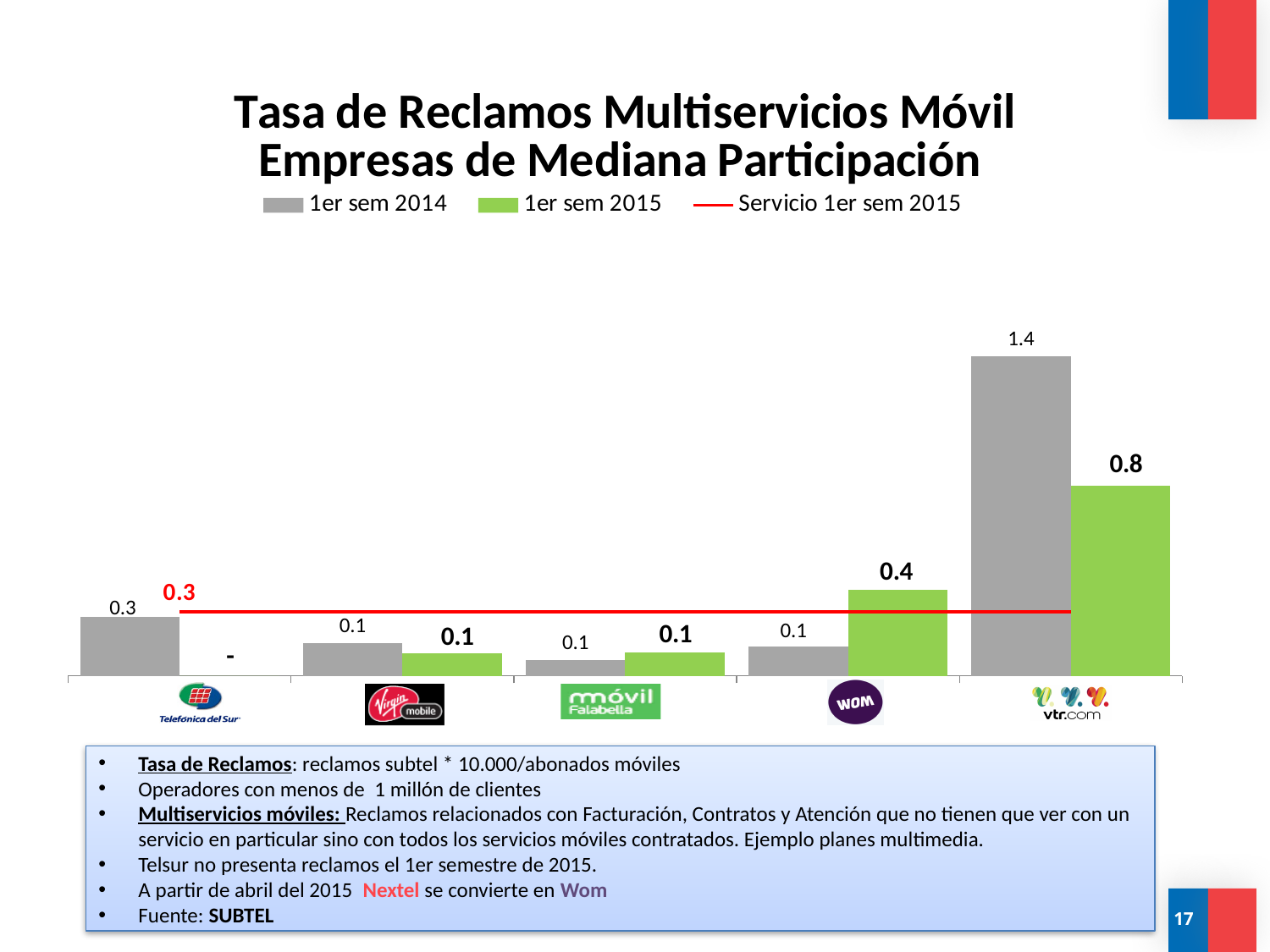
Which company has the highest value in the 1er sem 2015 series? VTR What is the value for Telefónica del Sur in the 1er sem 2014 series? 0.3 What is the value for VTR in the 1er sem 2015 series? 0.8 What kind of chart is shown on the slide? Combination bar and line chart Which is larger for WOM: the 1er sem 2014 value or the 1er sem 2015 value? 1er sem 2015 What is the difference between VTR's 1er sem 2014 value and its 1er sem 2015 value? 0.6 How many companies are shown on the x axis of the chart? 5 How many entries does the chart legend list? 3 What is the value for WOM in the 1er sem 2015 series? 0.4 What is the value for VTR in the 1er sem 2014 series? 1.4 What value does the red 'Servicio 1er sem 2015' line show? 0.3 Which company has the highest value in the 1er sem 2014 series? VTR